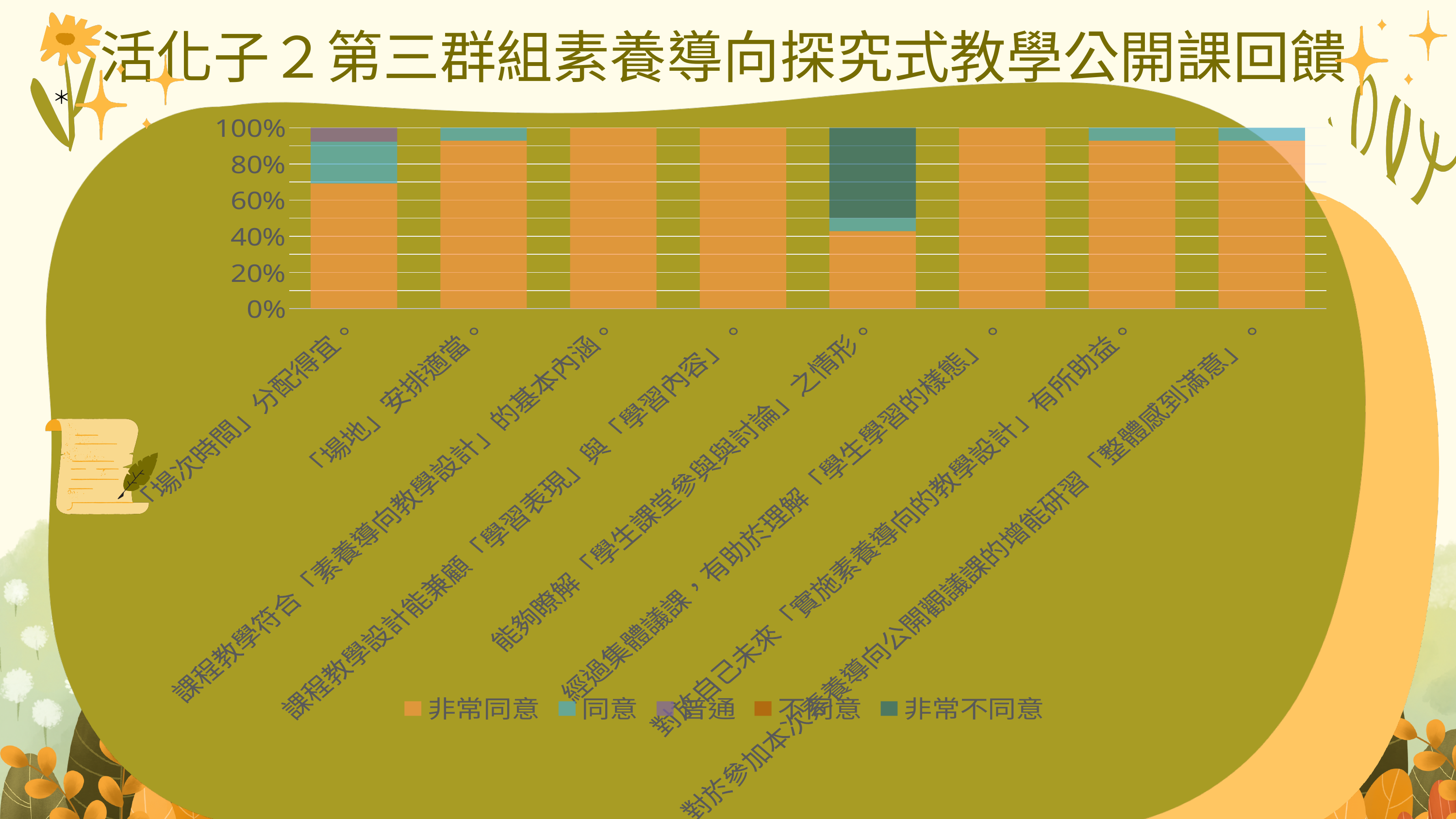
Which category is the only one with a 普通 segment? 「場次時間」分配得宜。 Is the 非常同意 share for 能夠瞭解「學生課堂參與與討論」之情形。 greater or less than 60%? less Is the 非常同意 share for 「場地」安排適當。 greater or less than 80%? greater How many categories (survey items) are plotted along the x axis? 8 Which has the larger 非常同意 share: 「場次時間」分配得宜。 or 「場地」安排適當。? 「場地」安排適當。 What kind of chart is shown on the slide? stacked bar chart What is the title of the slide containing the chart? 活化子２第三群組素養導向探究式教學公開課回饋 For 能夠瞭解「學生課堂參與與討論」之情形。, which is larger: the 同意 share or the 非常不同意 share? 非常不同意 Which category has the lowest share of 非常同意? 能夠瞭解「學生課堂參與與討論」之情形。 Is the 非常同意 share for 「場次時間」分配得宜。 greater or less than 60%? greater How many series does the legend list? 5